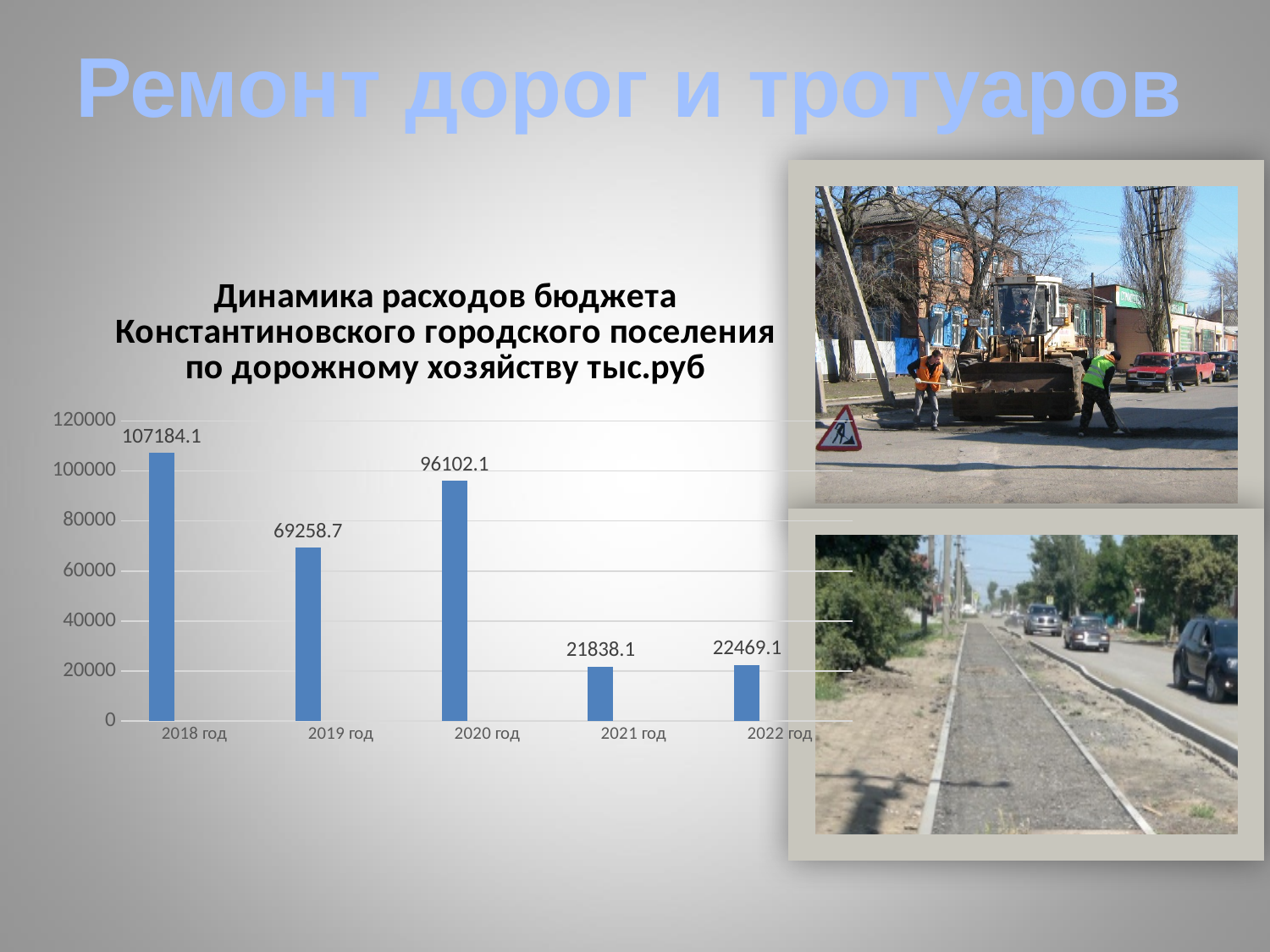
Which year has the highest value? 2018 год What is the value for 2018 год? 107184.1 Which is larger, the value for 2019 год or 2020 год? 2020 год What kind of chart is shown on the slide? bar chart What is the difference between the values for 2018 год and 2020 год? 11082 What is the title of the chart? Динамика расходов бюджета Константиновского городского поселения по дорожному хозяйству тыс.руб Is the value for 2019 год greater or less than 80000? less What is the value for 2021 год? 21838.1 Which year has the lowest value? 2021 год How many years are shown on the x axis? 5 What is the difference between the values for 2022 год and 2021 год? 631 What is the value for 2019 год? 69258.7